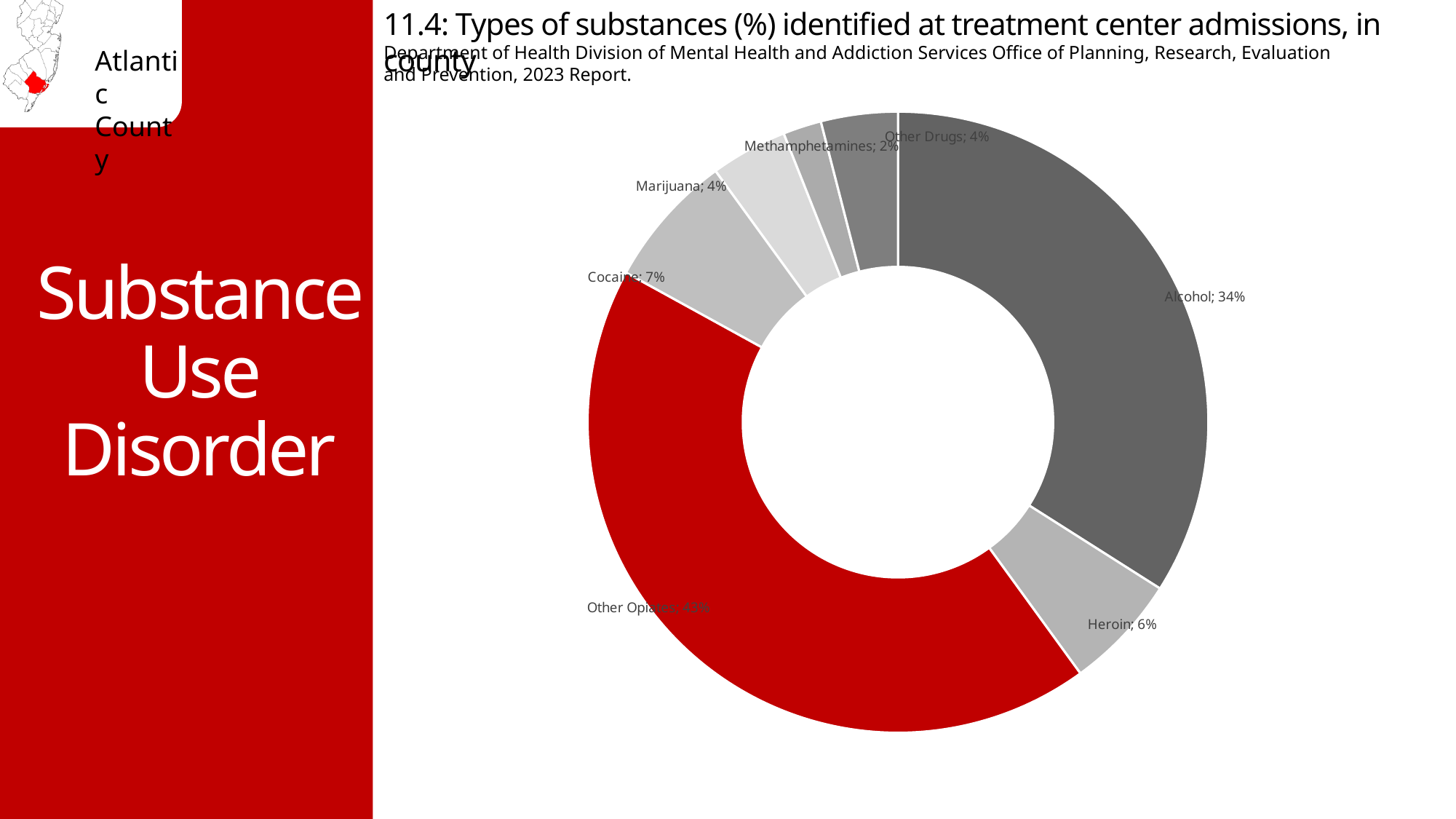
What is the difference in percentage points between Other Opiates and Alcohol? 9 Which substance has the largest share of treatment center admissions? Other Opiates What percentage is shown for Other Opiates? 43% How many substance categories are shown in the chart? 7 What percentage is shown for Cocaine? 7% What percentage is shown for Heroin? 6% Which has a larger share, Cocaine or Heroin? Cocaine What percentage is shown for Methamphetamines? 2% Which substance's slice is coloured red in the chart? Other Opiates What percentage of treatment center admissions is attributed to Alcohol? 34% Which substance has the smallest share of treatment center admissions? Methamphetamines What kind of chart is used on this slide? Doughnut chart